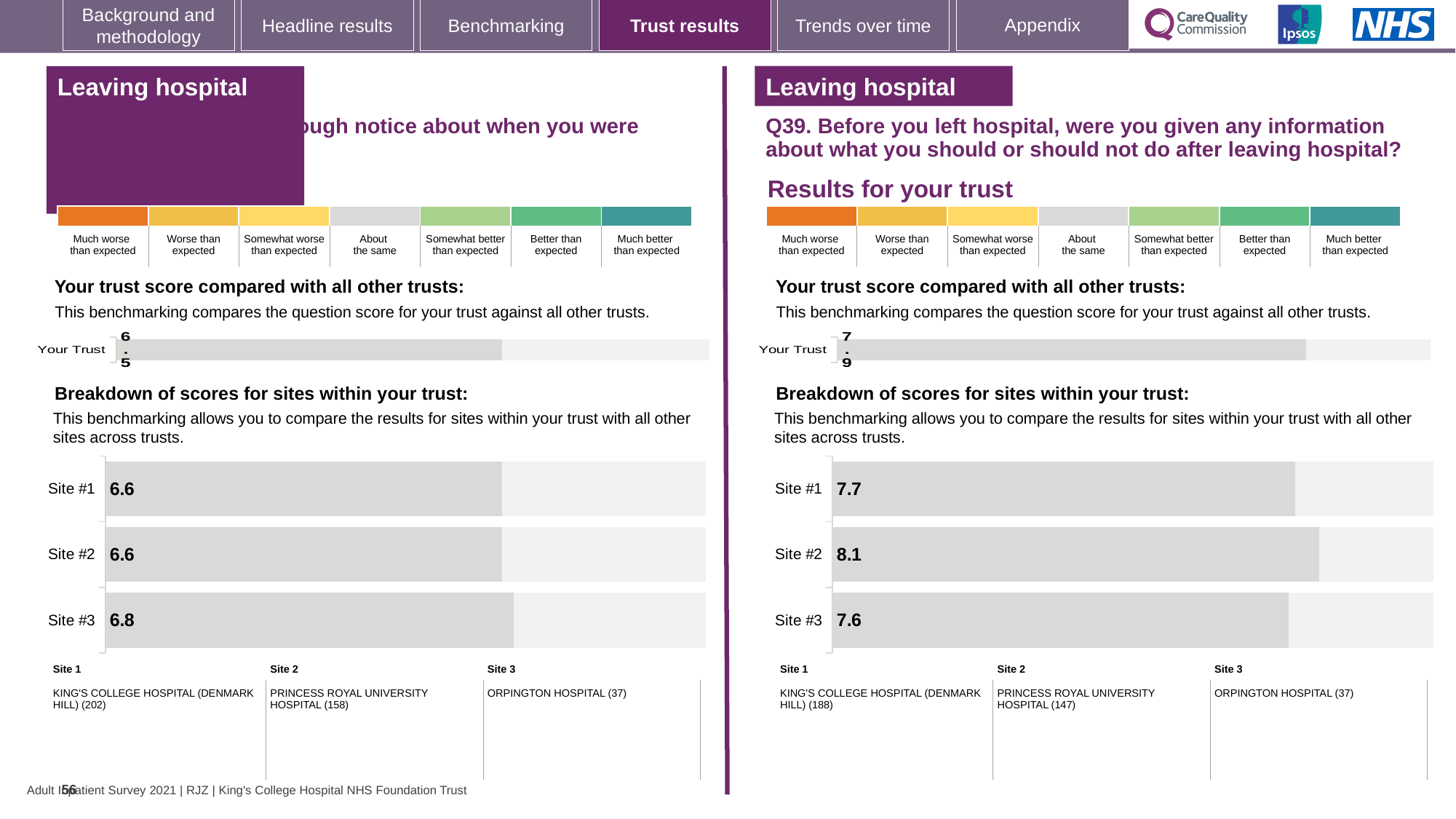
On the left-hand site breakdown chart, which site has the highest score? Site #3 On the right-hand (Q39) site breakdown chart, which has the larger score, Site #1 or Site #3? Site #1 On the right-hand (Q39) site breakdown chart, what is the difference between the scores for Site #2 and Site #3? 0.5 On the left-hand 'Your trust score compared with all other trusts' chart, what is the score for Your Trust? 6.5 How many sites are shown on the left-hand site breakdown chart? 3 On the right-hand (Q39) site breakdown chart, which site has the highest score? Site #2 On the left-hand site breakdown chart, what is the score for Site #3? 6.8 On the right-hand (Q39) site breakdown chart, which site has the lowest score? Site #3 On the left-hand site breakdown chart, what is the difference between the scores for Site #3 and Site #1? 0.2 On the right-hand (Q39) 'Your trust score compared with all other trusts' chart, what is the score for Your Trust? 7.9 On the right-hand (Q39) site breakdown chart, what is the score for Site #2? 8.1 What type of chart is the left-hand site breakdown chart? Bar chart